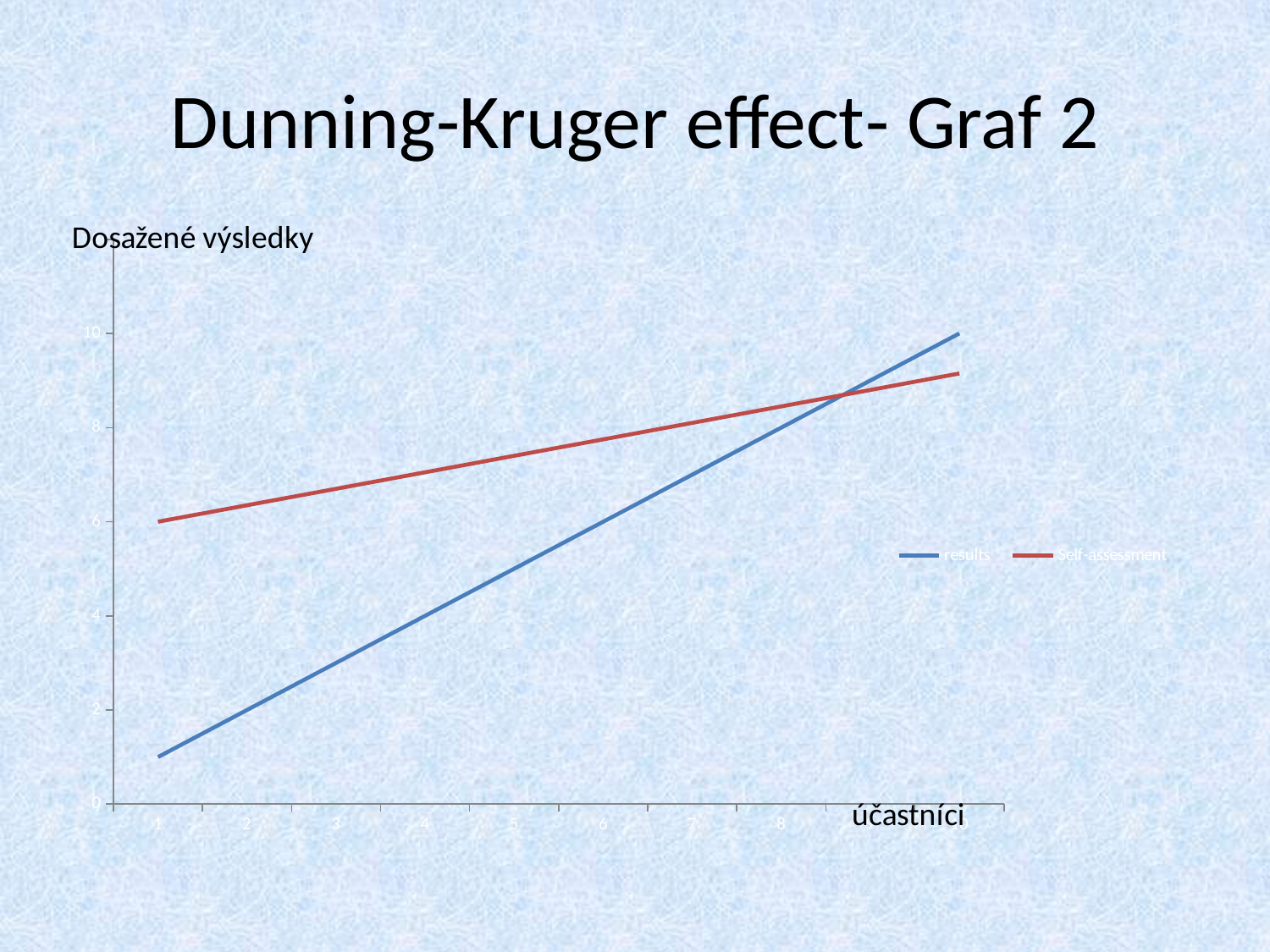
Is the value of the results series at participant 3 greater or less than 2? greater What kind of chart is shown on the slide? line chart Do the values of the results series rise or fall along the x axis? rise Which series has the lower value at participant 1? results How many series does the legend list? 2 Is the value of the results series at participant 5 greater or less than 4? greater What colour is the line for the results series? blue At participant 2, which series has the larger value, results or Self-assessment? Self-assessment Is the value of the Self-assessment series at participant 5 greater or less than 6? greater What is the title of the slide containing the chart? Dunning-Kruger effect- Graf 2 What is the value of the Self-assessment series at participant 1? 6